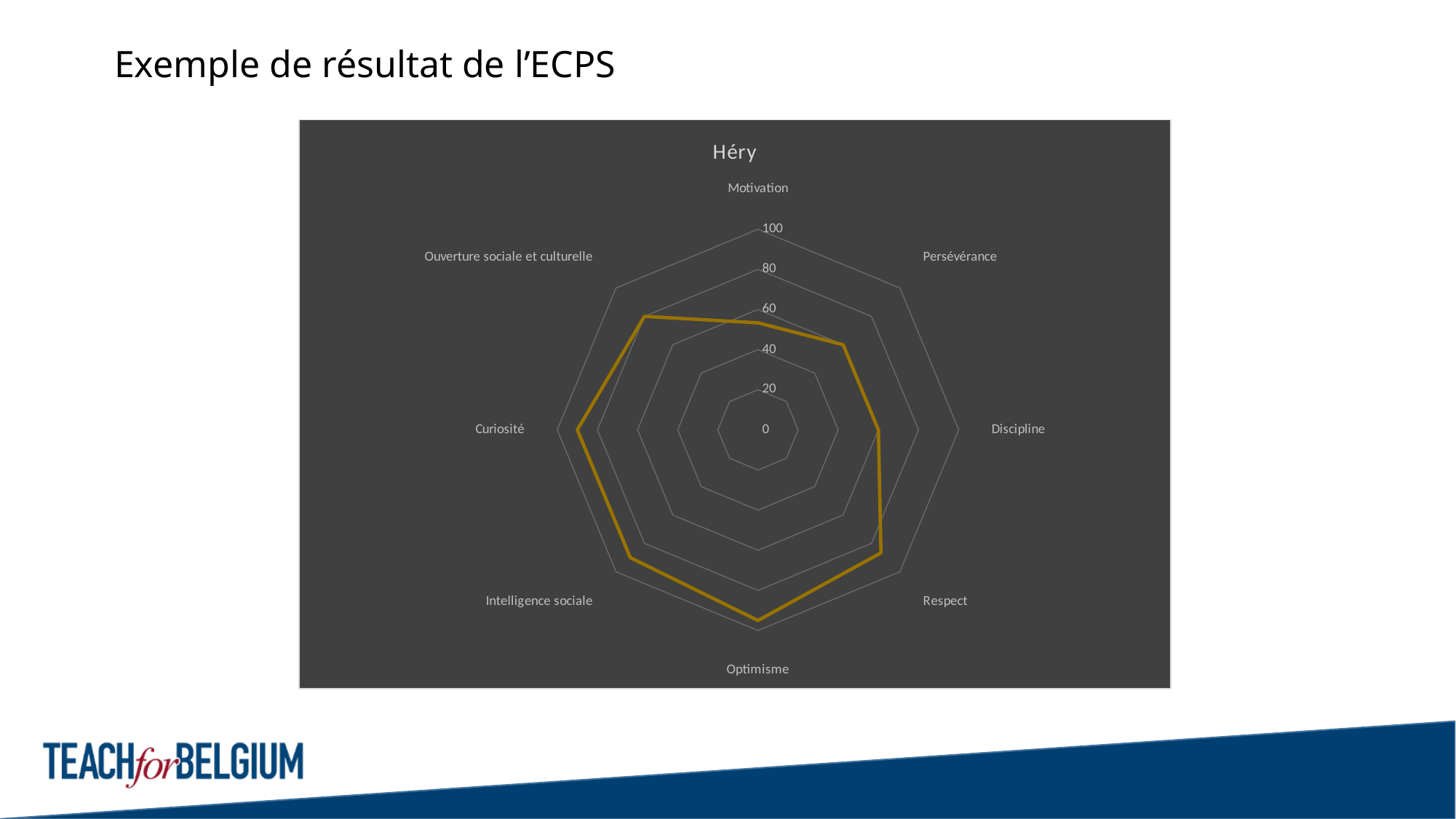
What is the maximum value shown on the chart's axis scale? 100 Is the value for Intelligence sociale greater or less than 80? greater Which is larger, the value for Optimisme or the value for Motivation? Optimisme How many categories (axes) does the radar chart have? 8 Is the value for Motivation greater or less than 40? greater Which is larger, the value for Curiosité or the value for Discipline? Curiosité Is the value for Curiosité greater or less than 80? greater What is the title of the chart? Héry What kind of chart is shown on the slide? radar chart